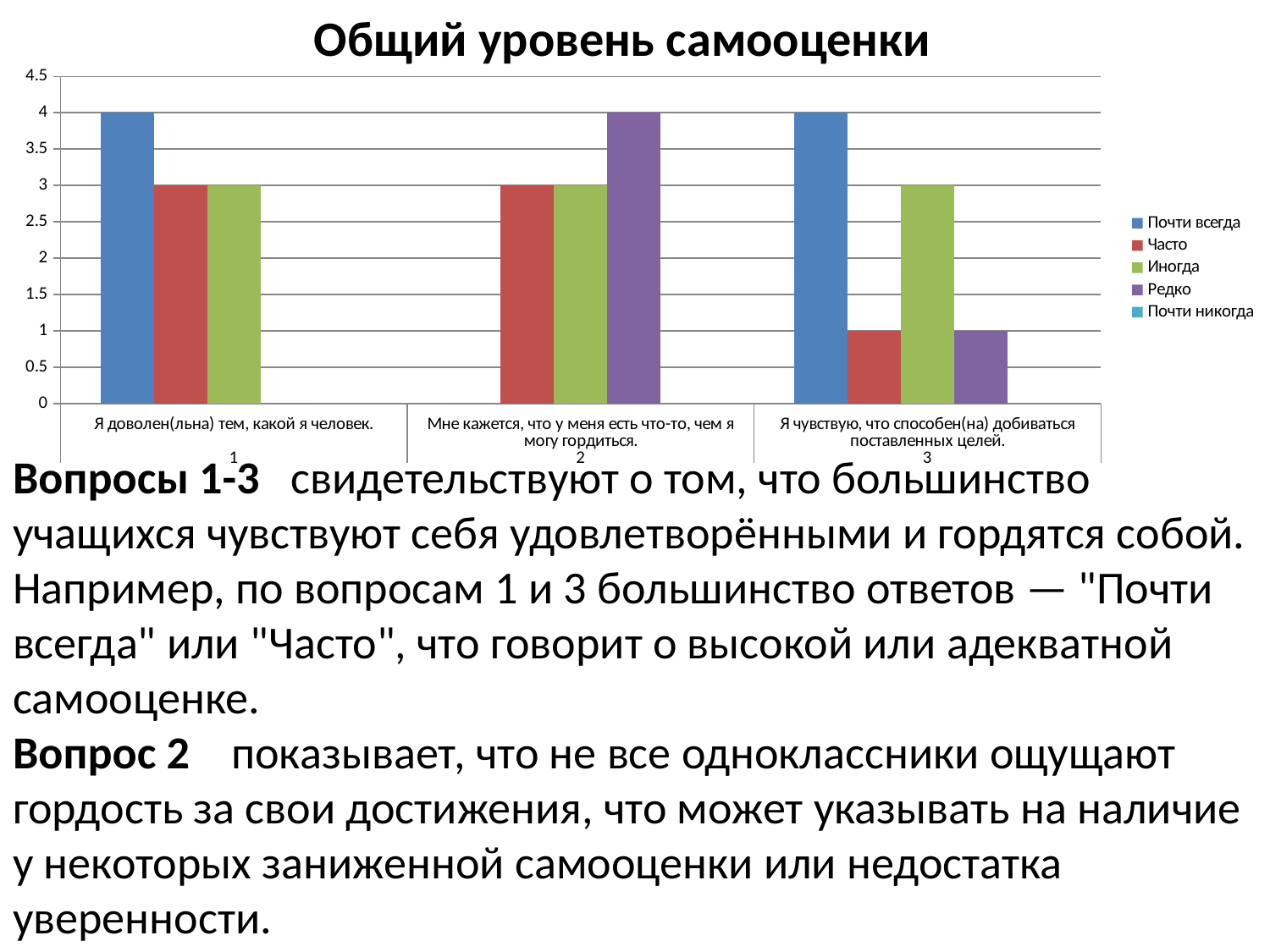
Which series has the highest value in category 2? Редко What is the title of the chart? Общий уровень самооценки What is the value for "Редко" in category 2 ("Мне кажется, что у меня есть что-то, чем я могу гордиться.")? 4 Which legend entry is shown in purple? Редко What type of chart is shown on the slide? bar chart What is the difference between "Почти всегда" and "Часто" in category 3? 3 Which series has the highest value in category 3? Почти всегда In category 1, which is larger: the value for "Почти всегда" or the value for "Иногда"? Почти всегда What is the value for "Часто" in category 3 ("Я чувствую, что способен(на) добиваться поставленных целей.")? 1 How many categories (questions) are shown on the x axis? 3 What is the value for "Почти всегда" in category 1 ("Я доволен(льна) тем, какой я человек.")? 4 How many series does the legend list? 5